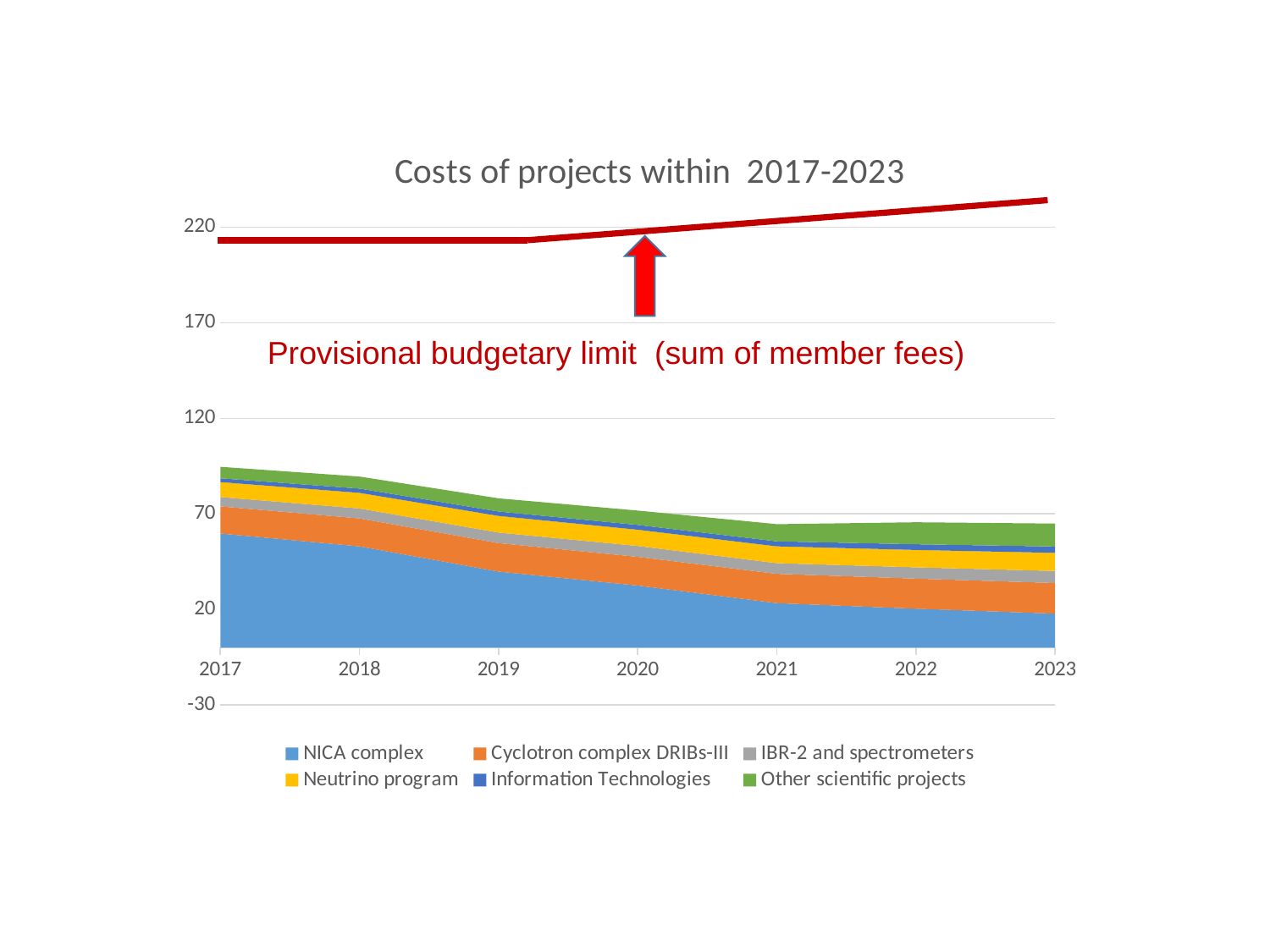
Does the total stacked cost rise or fall from 2017 to 2023? fall Is the value for the NICA complex larger in 2017 or in 2023? 2017 Is the total stacked cost in 2023 greater or less than 70? less How many years are plotted along the x axis? 7 What kind of chart is shown on the slide? area chart How many series does the legend list? 6 Is the total stacked cost in 2017 greater or less than 120? less What is the title of the chart? Costs of projects within 2017-2023 Is the value for the NICA complex in 2017 greater or less than 20? greater Which colour represents the NICA complex series? blue Do the values for the NICA complex rise or fall from 2017 to 2023? fall